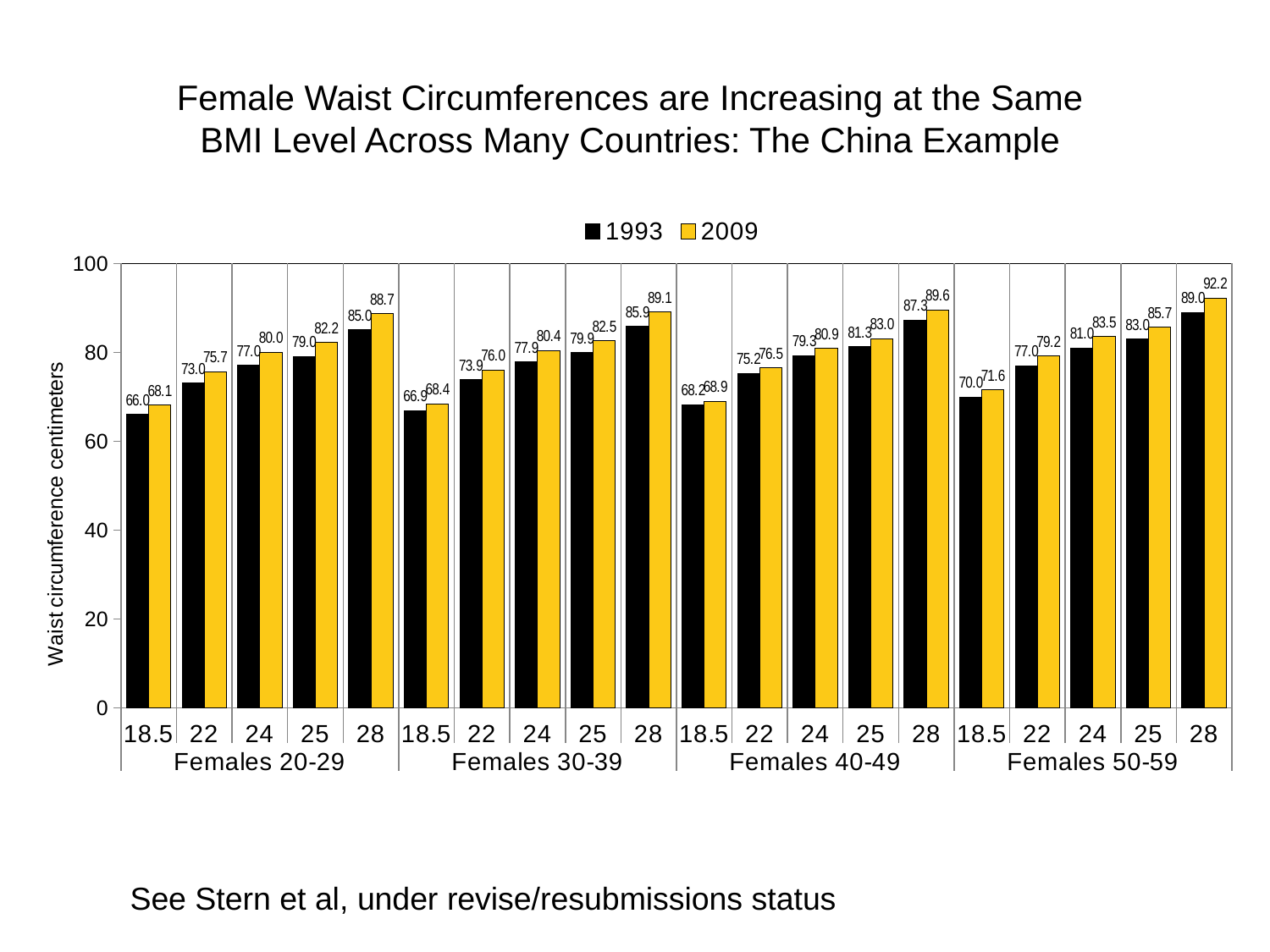
Which is larger: the 1993 value for Females 50-59 at BMI 28 or the 2009 value for Females 40-49 at BMI 28? 2009 value for Females 40-49 at BMI 28 What is the 1993 value for Females 40-49 at BMI 25? 81.3 What is the 2009 waist circumference for Females 50-59 at BMI 28? 92.2 Which bar has the highest value on the chart? 2009, Females 50-59, BMI 28 Which bar has the lowest value on the chart? 1993, Females 20-29, BMI 18.5 Within each age group, do the waist circumference values rise or fall as BMI level increases? rise What is the 2009 value for Females 30-39 at BMI 24? 80.4 What is the difference between the 2009 and 1993 values for Females 20-29 at BMI 28? 3.7 Is the 1993 value for Females 30-39 at BMI 22 greater or less than 80? less What is the 1993 waist circumference for Females 20-29 at BMI 18.5? 66.0 What kind of chart is shown on the slide? bar chart How many series does the legend list? 2